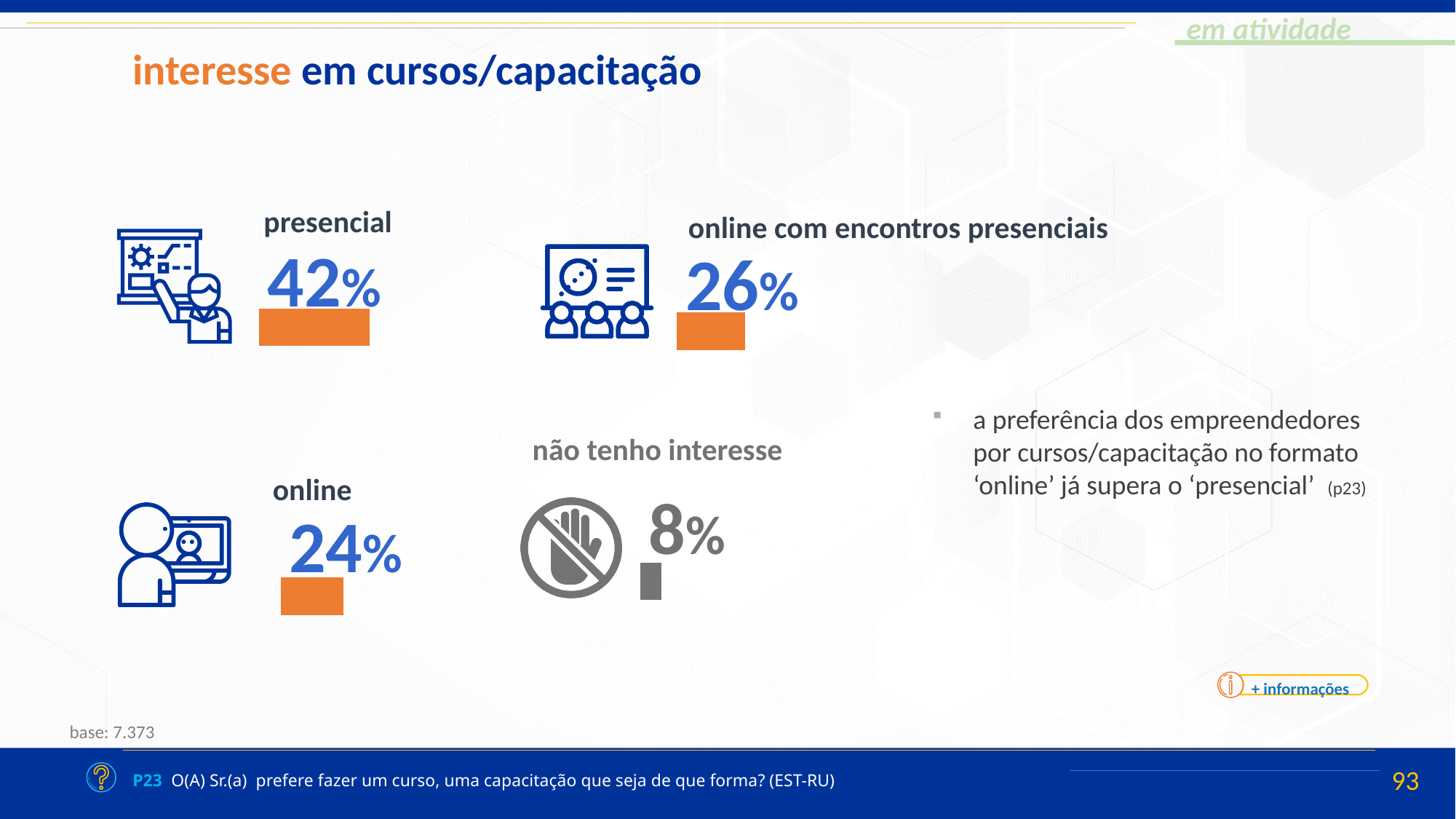
Which category has the lowest percentage? não tenho interesse What percentage of respondents prefer 'presencial' courses? 42% How many response categories are shown on the slide? 4 What is the value shown for 'online com encontros presenciais'? 26% Which category has the highest percentage? presencial Which is larger, the value for 'presencial' or the value for 'online com encontros presenciais'? presencial What percentage is shown for 'online'? 24% What is the difference between 'online com encontros presenciais' and 'online'? 2% What kind of chart is used to show the values on this slide? bar chart What is the base (number of respondents) shown on the slide? 7.373 What percentage of respondents answered 'não tenho interesse'? 8% What is the difference between the 'presencial' and 'online' percentages? 18%